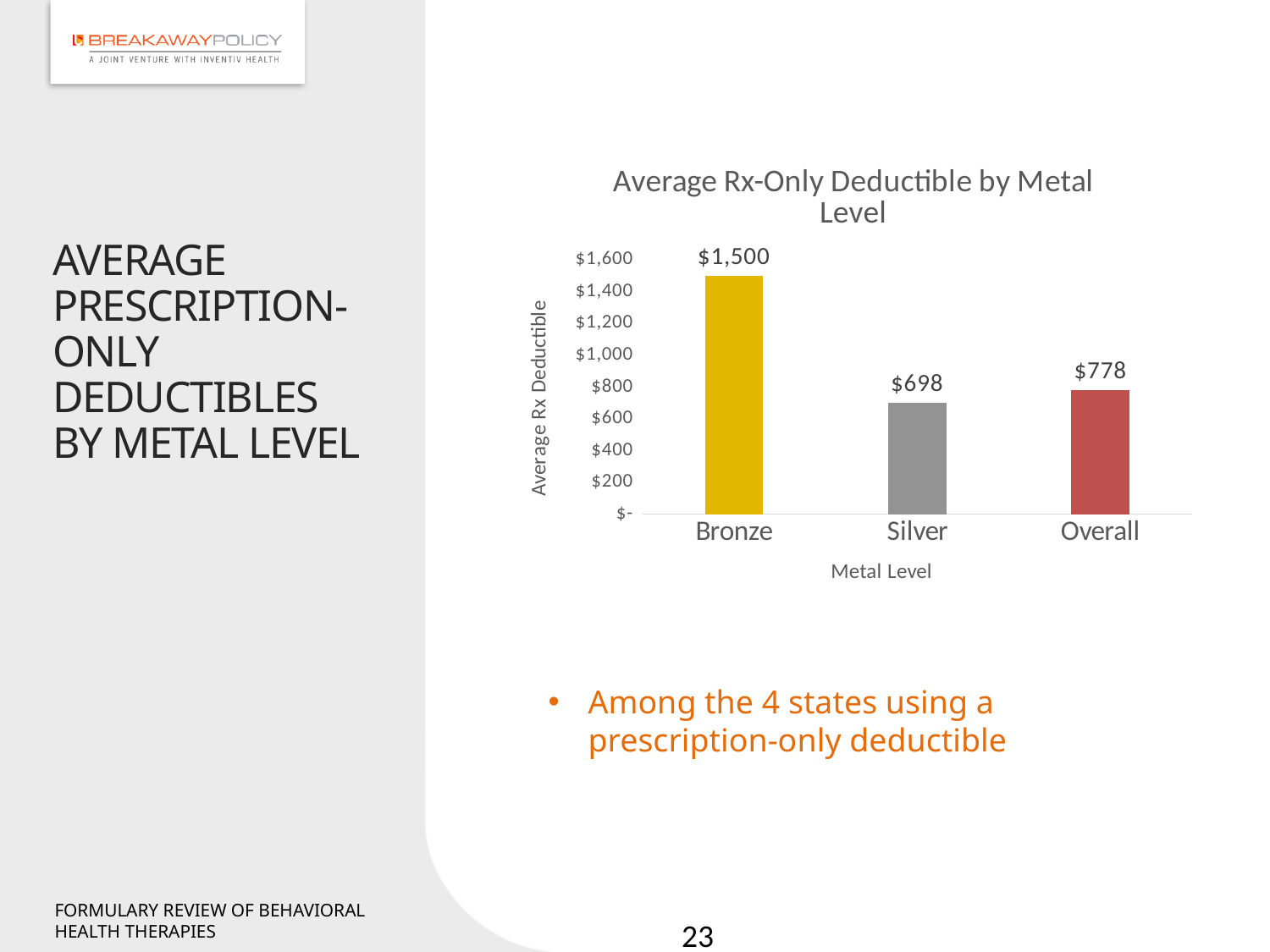
What is the difference between the Overall and Silver average Rx-only deductibles? $80 What is the difference between the Bronze and Silver average Rx-only deductibles? $802 What is the average Rx-only deductible for Bronze? $1,500 Is the value for Bronze greater or less than $1,400? greater What is the title of the chart? Average Rx-Only Deductible by Metal Level Which is larger, the average Rx-only deductible for Silver or Overall? Overall What kind of chart is shown on the slide? Bar chart How many metal level categories are shown on the chart? 3 What is the average Rx-only deductible for Silver? $698 What is the Overall average Rx-only deductible? $778 Which metal level has the highest average Rx-only deductible? Bronze Which category has the lowest average Rx-only deductible? Silver